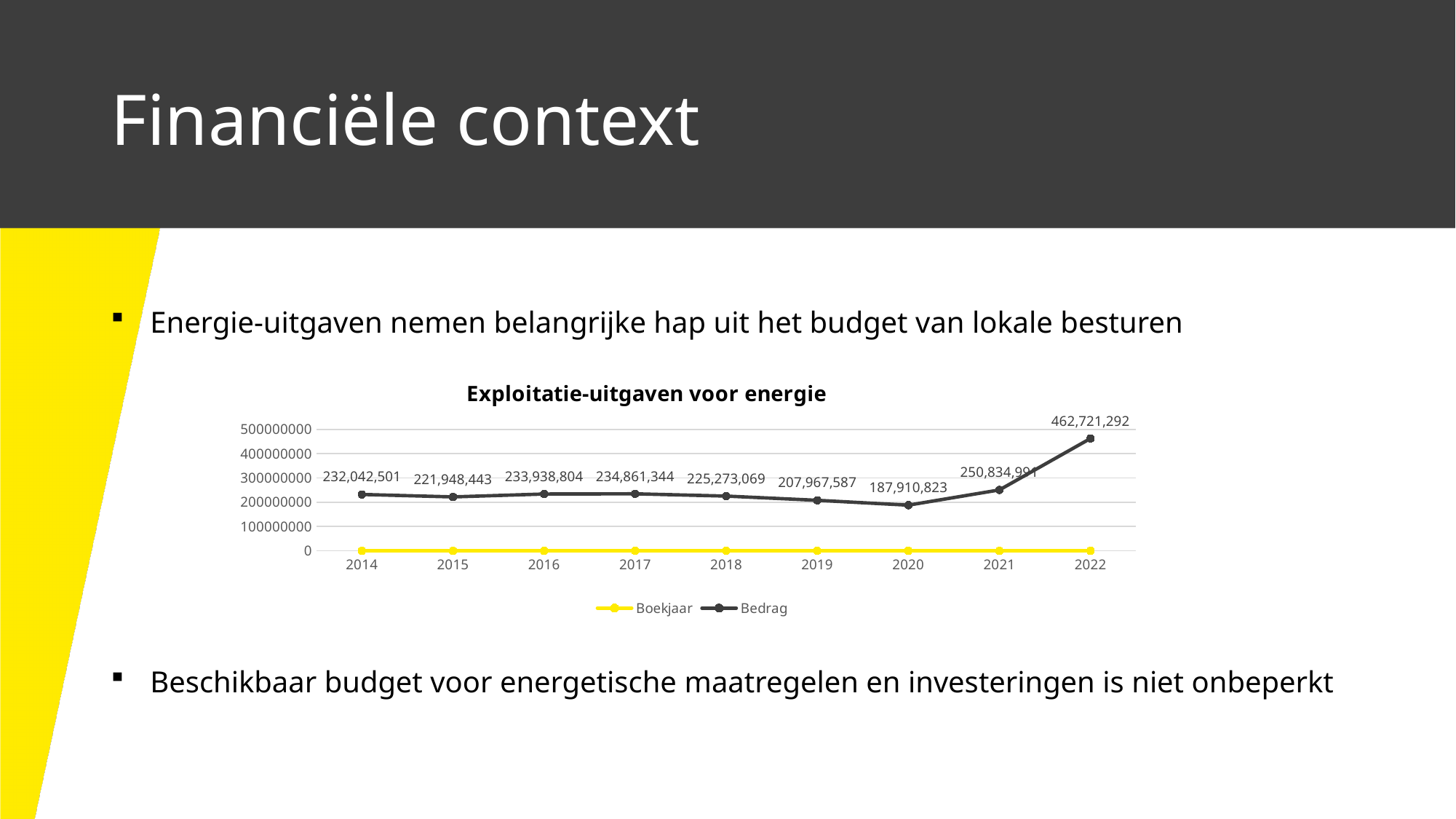
Which year has a larger Bedrag value, 2019 or 2016? 2016 What is the difference between the Bedrag values for 2017 and 2015? 12,912,901 What is the Bedrag value for 2022? 462,721,292 In which year is the Bedrag value highest? 2022 What kind of chart is shown on the slide? line chart Is the Bedrag value for 2022 greater or less than 400000000? greater How many years are plotted along the x axis of the chart? 9 What is the Bedrag value for 2020? 187,910,823 What is the Bedrag value for 2014? 232,042,501 In which year is the Bedrag value lowest? 2020 How many series does the chart legend list? 2 What is the title of the chart? Exploitatie-uitgaven voor energie